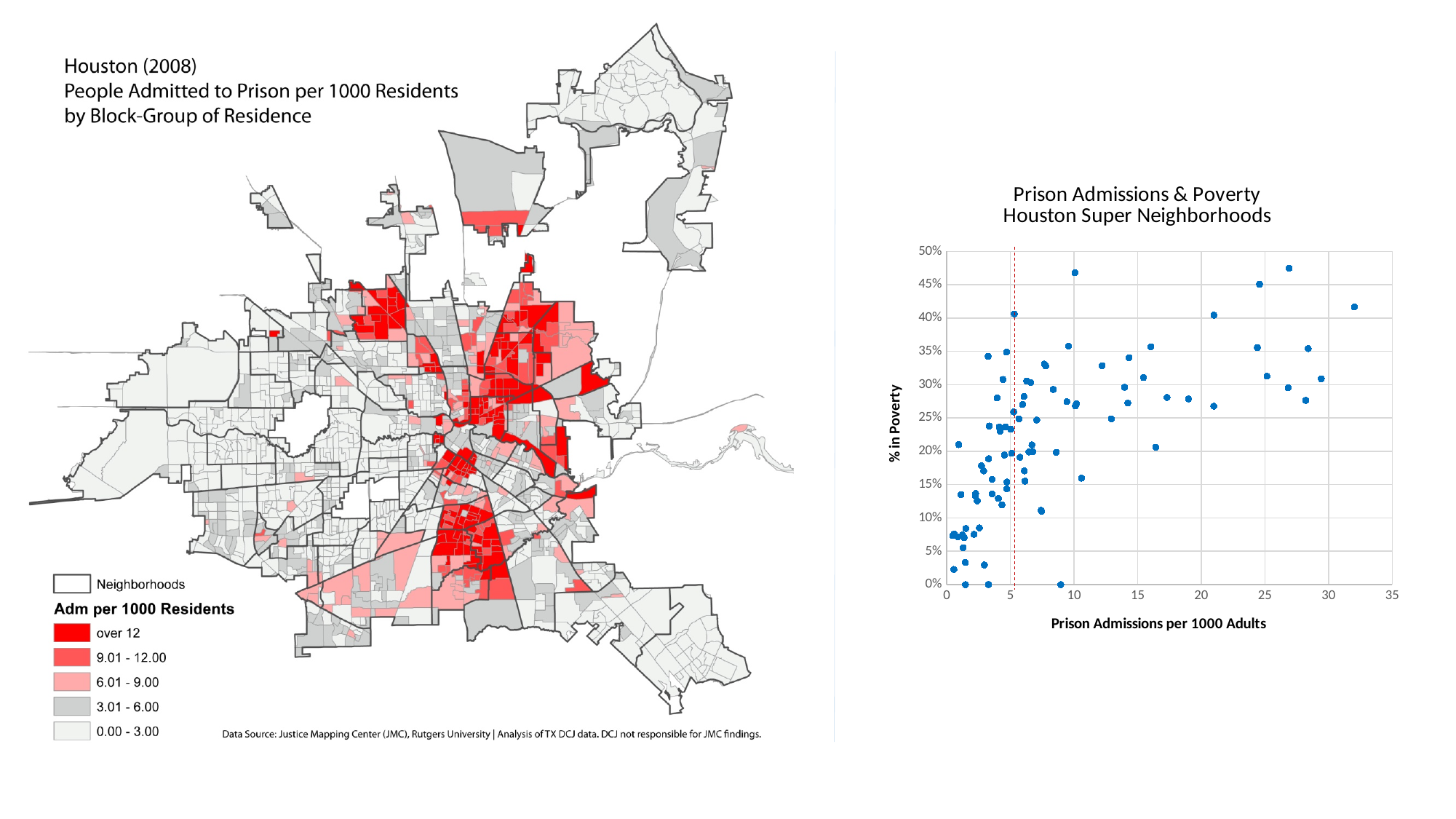
How many categories does the 'Adm per 1000 Residents' legend on the Houston map list? 5 What is the highest category in the 'Adm per 1000 Residents' legend on the Houston map? over 12 In the 'Prison Admissions & Poverty' chart, is the highest % in Poverty value plotted greater or less than 45%? greater In the 'Prison Admissions & Poverty' chart, does % in Poverty generally rise or fall as Prison Admissions per 1000 Adults increases? rise What kind of chart is 'Prison Admissions & Poverty Houston Super Neighborhoods'? scatter chart What is the x-axis title of the 'Prison Admissions & Poverty' chart? Prison Admissions per 1000 Adults In the 'Prison Admissions & Poverty' chart, is the highest Prison Admissions per 1000 Adults value plotted greater or less than 30? greater In the 'Prison Admissions & Poverty' chart, is the lowest Prison Admissions per 1000 Adults value plotted greater or less than 5? less